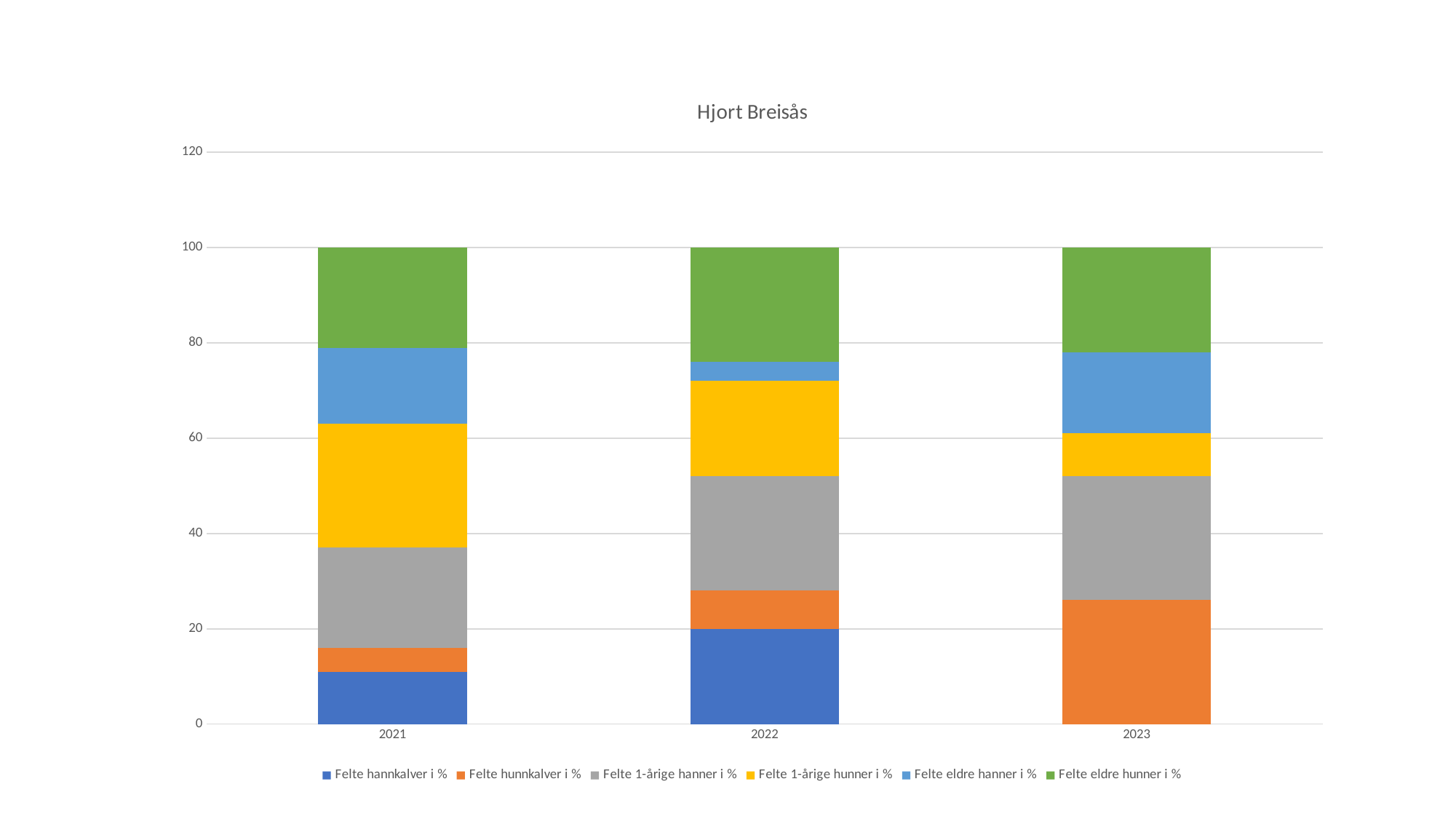
Which year has the largest Felte hunnkalver i % segment? 2023 Does the Felte hunnkalver i % segment rise or fall from 2021 to 2023? rise What is the total height of the stacked bar for 2021? 100 Is the value for Felte eldre hanner i % in 2022 greater or less than 20? less Which is larger, Felte eldre hanner i % in 2021 or in 2022? 2021 What kind of chart is shown on the slide? stacked bar chart Is the value for Felte 1-årige hunner i % in 2021 greater or less than 20? greater What is the value for Felte hannkalver i % in 2022? 20 Which year has the smallest Felte eldre hanner i % segment? 2022 What is the title of the chart? Hjort Breisås How many series does the legend list? 6 How many years are shown on the x axis? 3